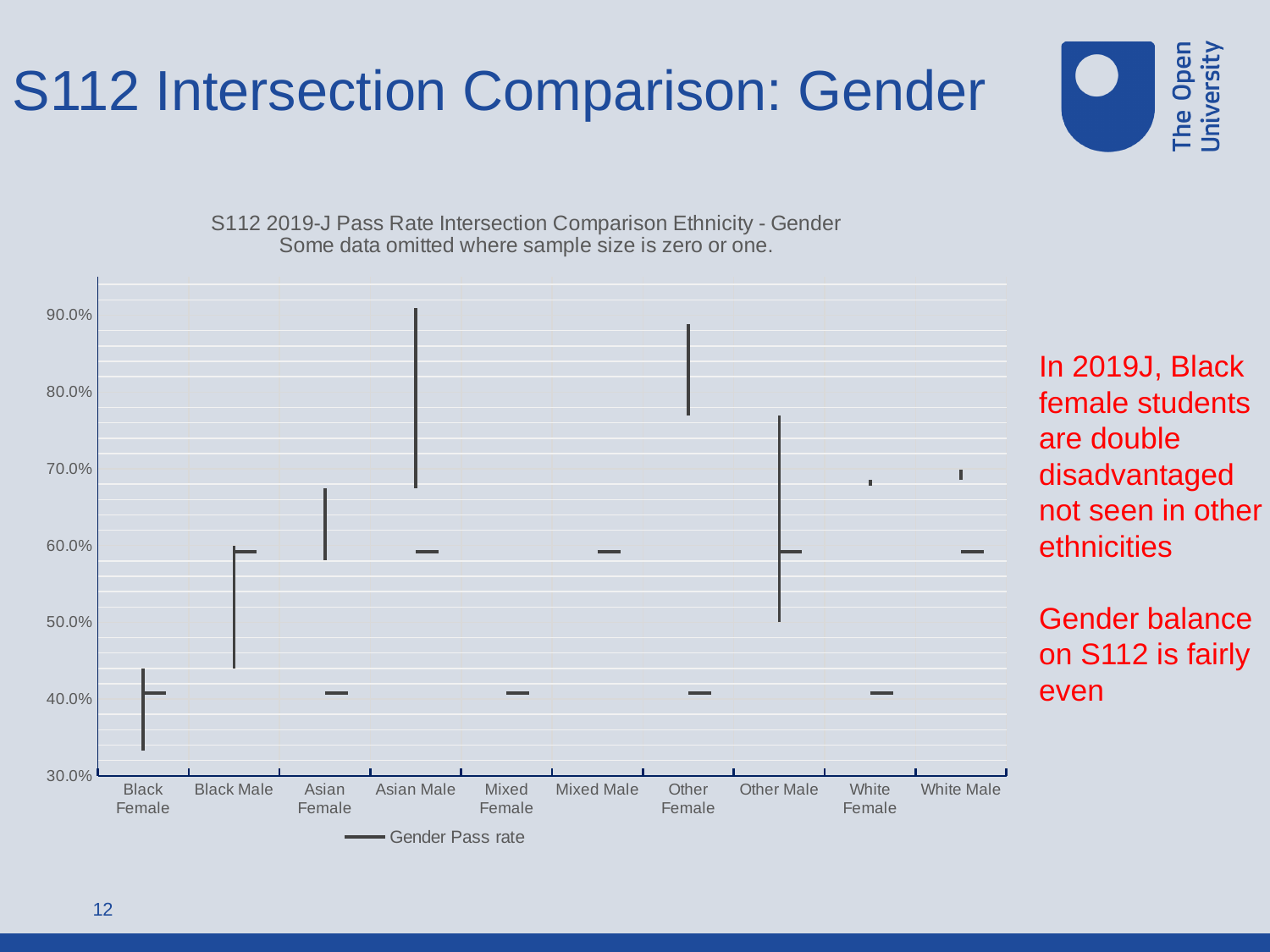
Is the mark plotted for White Female greater or less than 60.0%? greater Which category's vertical line reaches the highest value on the chart? Asian Male Which category's vertical line reaches the lowest value on the chart? Black Female Is the bottom of the vertical line for Other Male greater or less than 60.0%? less How many series does the chart legend list? 1 How many ethnicity-gender categories are shown on the x axis of the chart? 10 Is the top of the vertical line for Asian Male greater or less than 80.0%? greater What is the legend entry shown below the chart? Gender Pass rate What is the first line of the chart's title? S112 2019-J Pass Rate Intersection Comparison Ethnicity - Gender